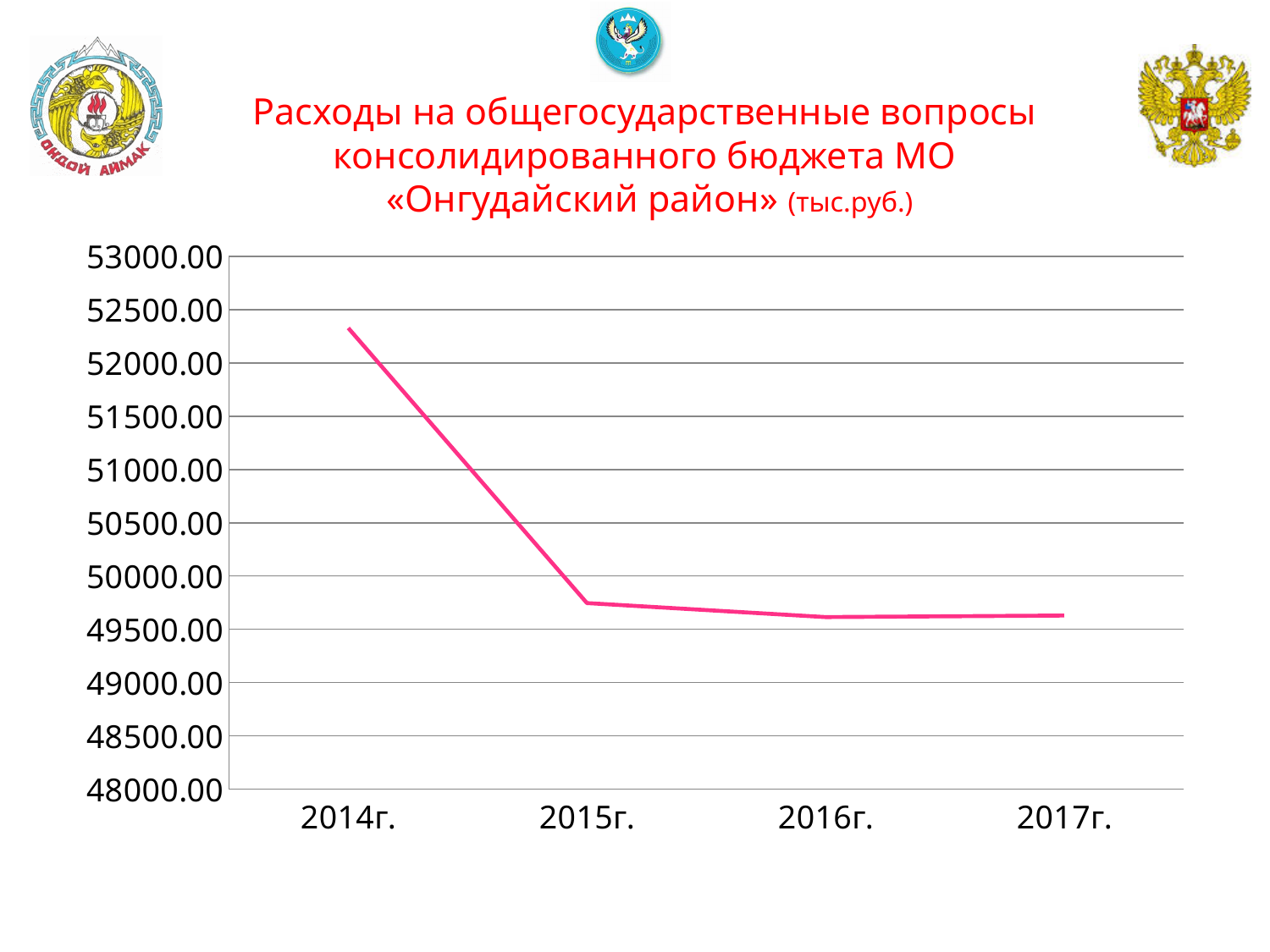
Is the value for 2016г. greater or less than 50000.00? less What is the first year shown on the x axis? 2014г. How many years (data points) are plotted on the chart? 4 Is the value for 2015г. greater or less than 50000.00? less Is the value for 2017г. greater or less than 49500.00? greater What unit is given in the chart title? тыс.руб. Which year has the highest value on the chart? 2014г. What kind of chart is shown on the slide? line chart How many lines (series) are plotted on the chart? 1 Do the values rise or fall from 2014г. to 2017г.? fall Which is larger, the value for 2014г. or the value for 2015г.? 2014г.